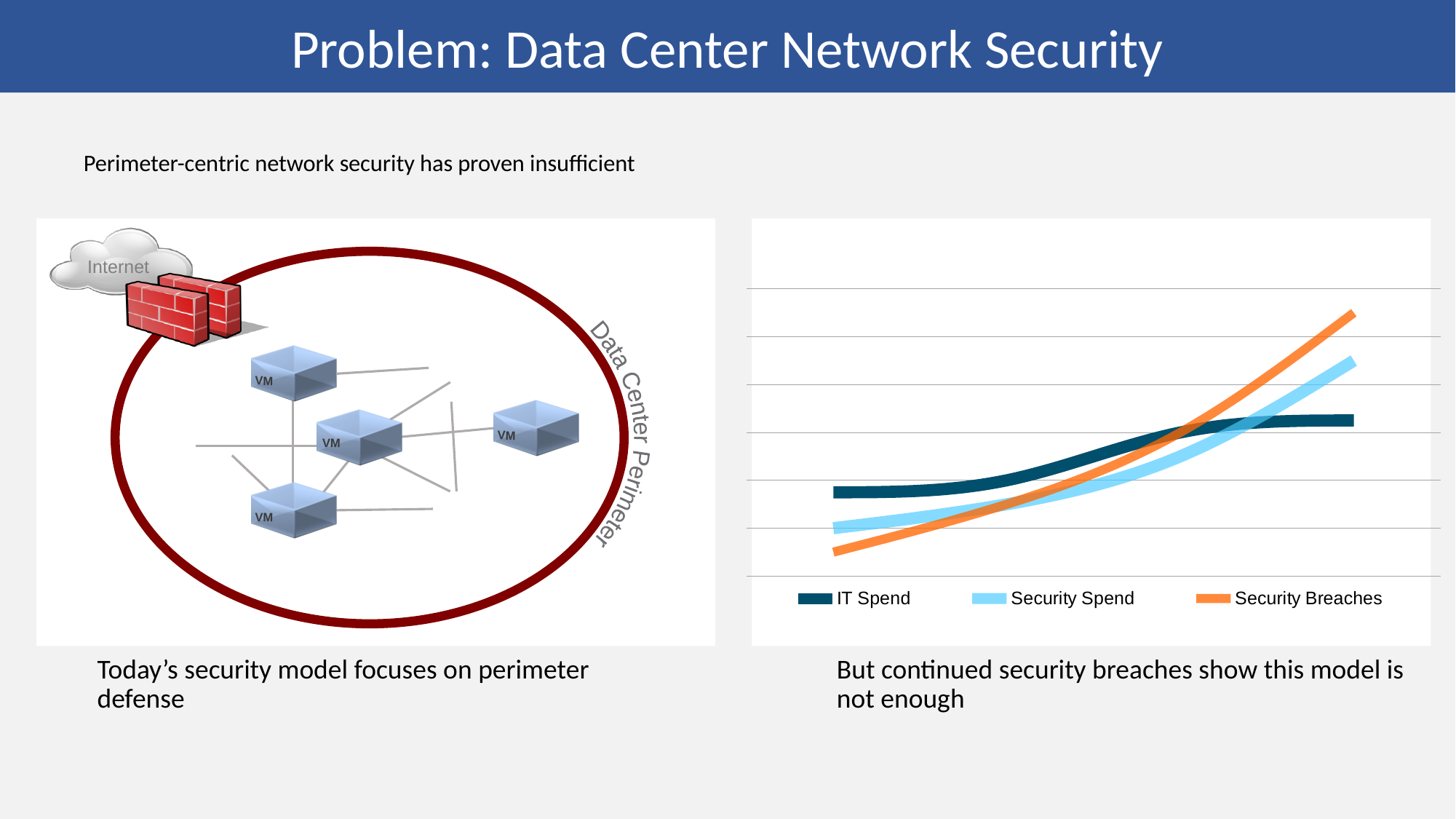
At the right end of the chart, which is larger: IT Spend or Security Spend? Security Spend Which series has the highest value at the left end of the chart? IT Spend Which series is drawn in orange? Security Breaches Which series has the lowest value at the left end of the chart? Security Breaches Do the values of the IT Spend series rise or fall from left to right? rise Which series flattens out toward the right end of the chart? IT Spend What kind of chart is shown on the right side of the slide? line chart Which series has the highest value at the right end of the chart? Security Breaches At the left end of the chart, which is larger: IT Spend or Security Breaches? IT Spend How many series does the legend of the chart list? 3 Do the values of the Security Breaches series rise or fall from left to right? rise What are the three series named in the chart's legend? IT Spend, Security Spend, Security Breaches